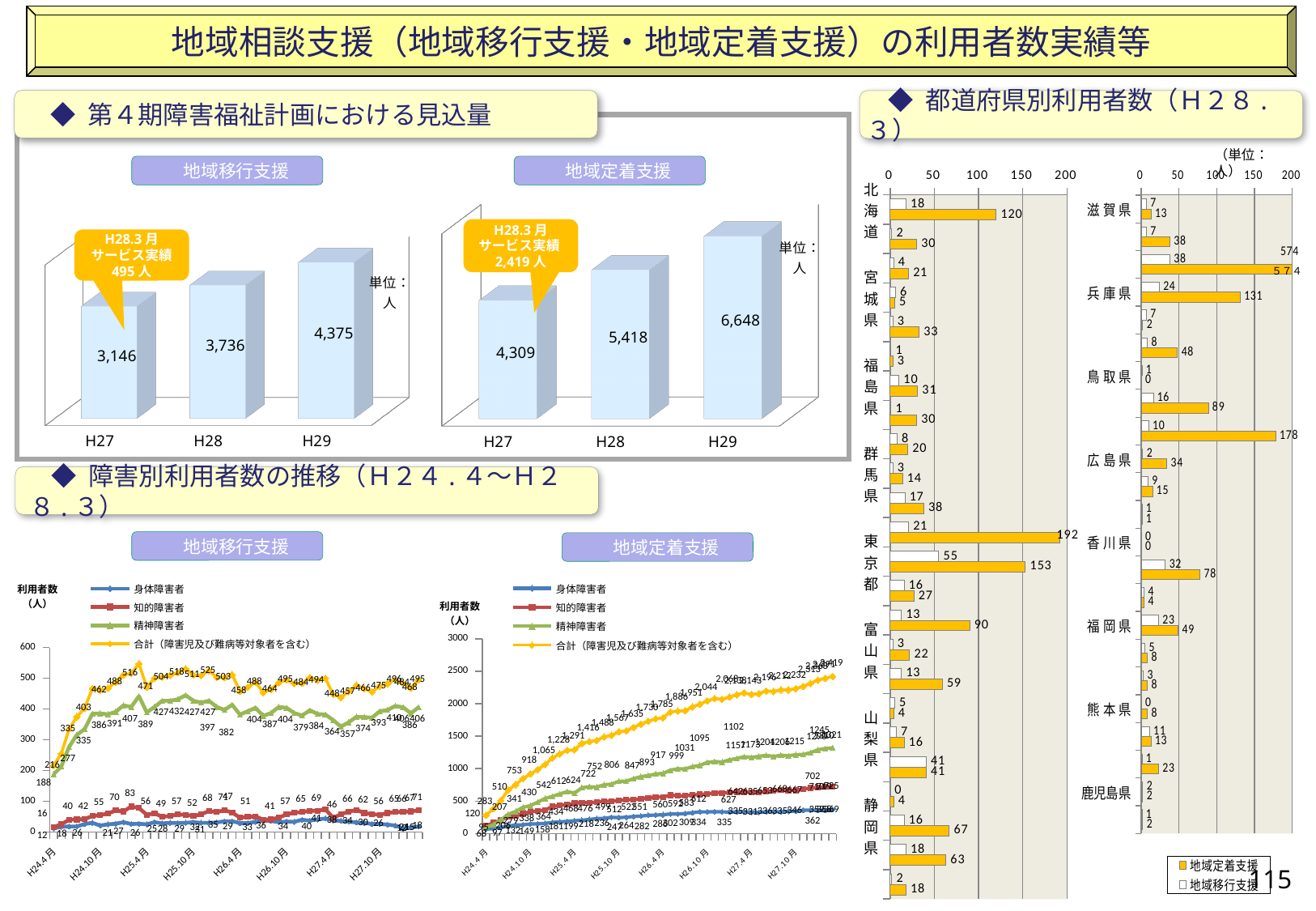
In the 第４期障害福祉計画における見込量 charts, which is larger for H29: 地域移行支援 or 地域定着支援? 地域定着支援 In the 第４期障害福祉計画における見込量 chart for 地域移行支援, how much larger is the H28 value than the H27 value? 590 How many series does the legend list in the 障害別利用者数の推移 chart for 地域移行支援? 4 How many series does the legend list in the 都道府県別利用者数（Ｈ２８．３） chart? 2 In the 第４期障害福祉計画における見込量 chart for 地域定着支援, what is the value for H27? 4,309 What kind of chart is the 障害別利用者数の推移 chart for 地域定着支援? line chart In the 第４期障害福祉計画における見込量 chart for 地域移行支援, what is the value for H29? 4,375 In the 第４期障害福祉計画における見込量 chart for 地域定着支援, what is the difference between the H29 and H27 values? 2,339 How many categories (years) are shown in the 第４期障害福祉計画における見込量 chart for 地域定着支援? 3 What kind of chart is used for the 第４期障害福祉計画における見込量 section? bar chart In the 都道府県別利用者数（Ｈ２８．３） chart, what is the 地域定着支援 value for 東京都? 153 In the 第４期障害福祉計画における見込量 chart for 地域移行支援, do the values rise or fall from H27 to H29? rise